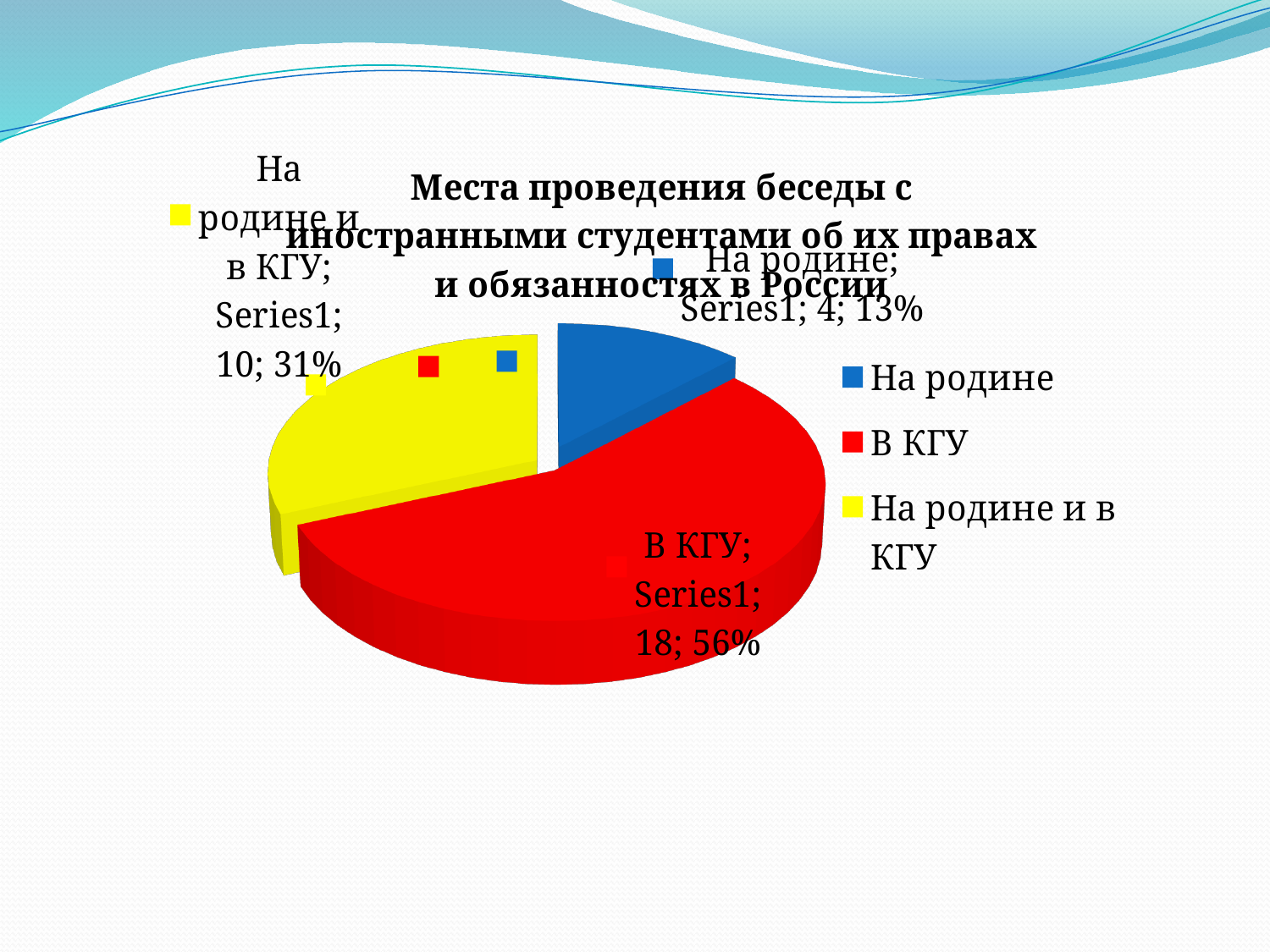
Which colour represents "На родине и в КГУ" in the pie chart? yellow What value is shown for the slice "В КГУ"? 18 Which slice of the pie is the smallest? На родине What is the difference between the values for "В КГУ" and "На родине и в КГУ"? 8 How many slices does the pie chart have? 3 What percentage share of the pie does "На родине" have? 13% What percentage share of the pie does "На родине и в КГУ" have? 31% What value is shown for the slice "На родине"? 4 What value is shown for the slice "На родине и в КГУ"? 10 What percentage share of the pie does "В КГУ" have? 56% What kind of chart is shown on the slide? pie chart Which slice of the pie is the largest? В КГУ